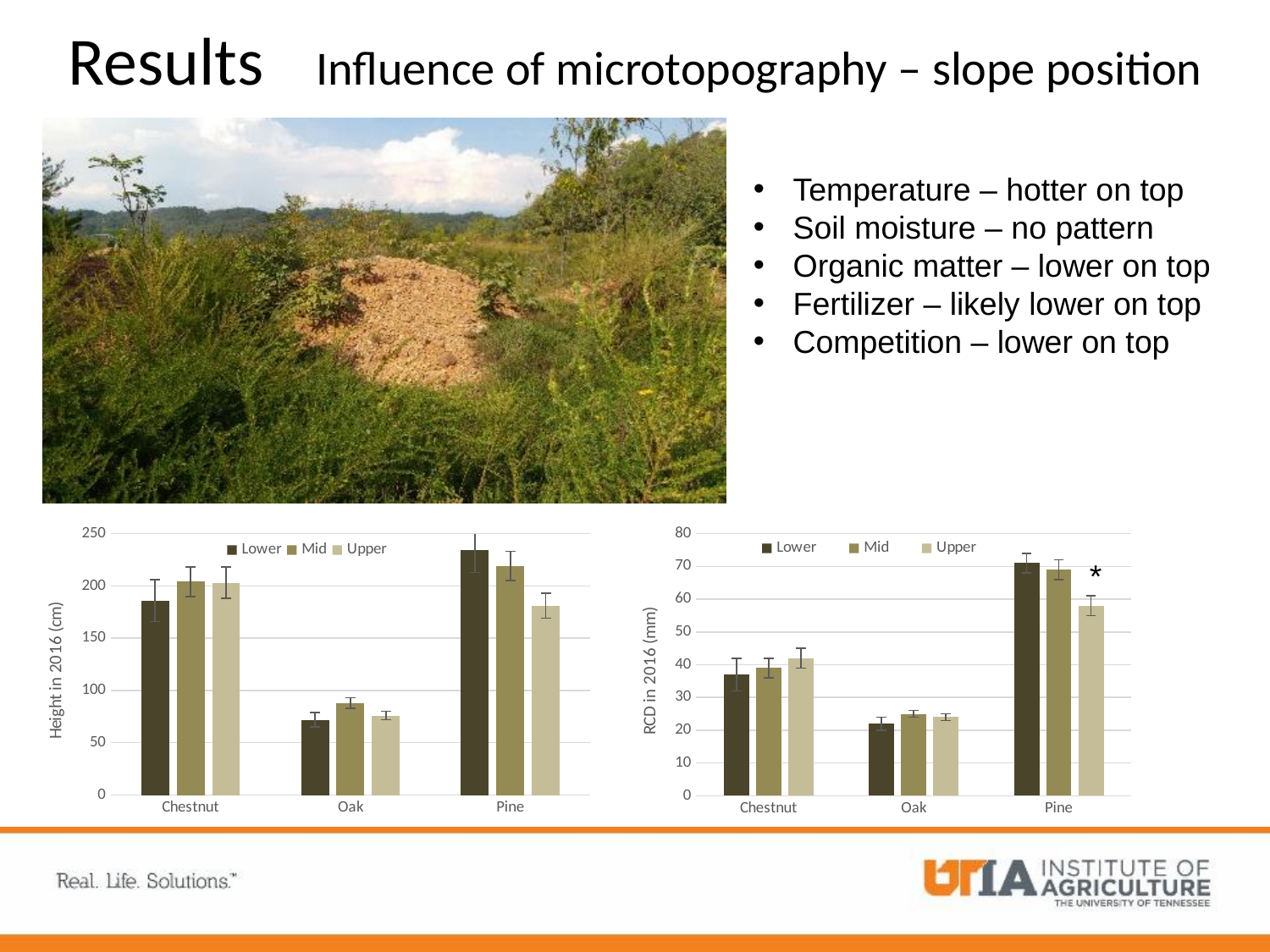
What kind of chart is the left chart (Height in 2016)? bar chart In the right chart (RCD in 2016), which slope position has the highest value for Pine? Lower In the right chart (RCD in 2016), is the Lower value for Oak greater or less than 30? less In the right chart (RCD in 2016), is the Upper value for Pine greater or less than 50? greater How many tree species categories are shown on the x axis of the left chart (Height in 2016)? 3 In the left chart (Height in 2016), which species has the lowest heights across all slope positions? Oak In the left chart (Height in 2016), is the Lower value for Pine greater or less than 200? greater In the left chart (Height in 2016), which is larger for Pine: the Lower value or the Upper value? Lower How many series does the legend of the right chart (RCD in 2016) list? 3 In the right chart (RCD in 2016), which is larger for Chestnut: the Lower value or the Upper value? Upper What is the y-axis title of the right chart? RCD in 2016 (mm)